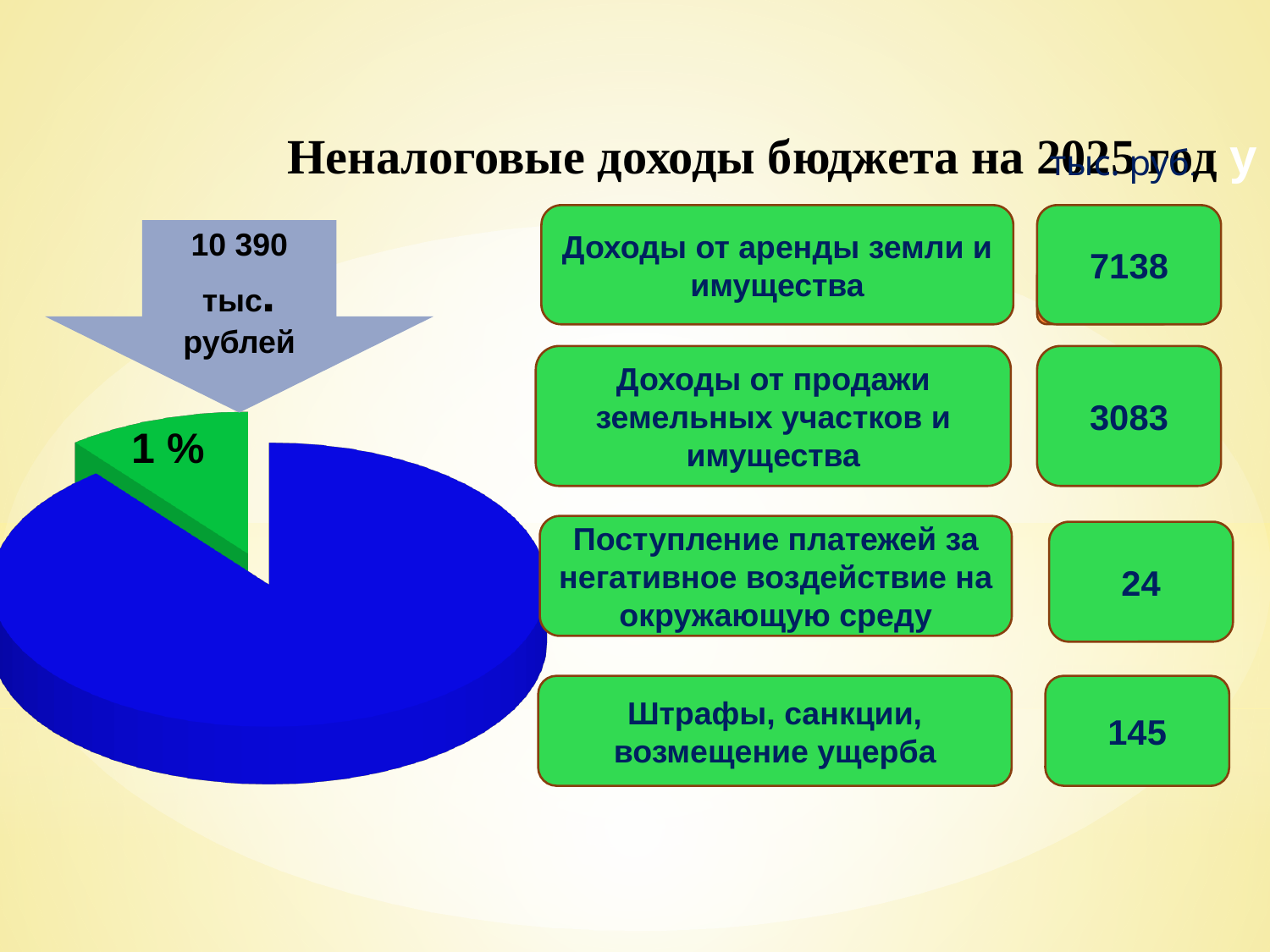
What colour is the slice labelled "1 %" in the pie chart? green Which slice of the pie chart is the smallest? the green slice How many slices does the pie chart have? 2 What is the title of the slide containing the pie chart? Неналоговые доходы бюджета на 2025 год Is the blue slice or the green slice of the pie chart larger? the blue slice What share of the pie does the green slice represent? 1 % What kind of chart is shown on the slide? pie chart Which slice of the pie chart is the largest? the blue slice